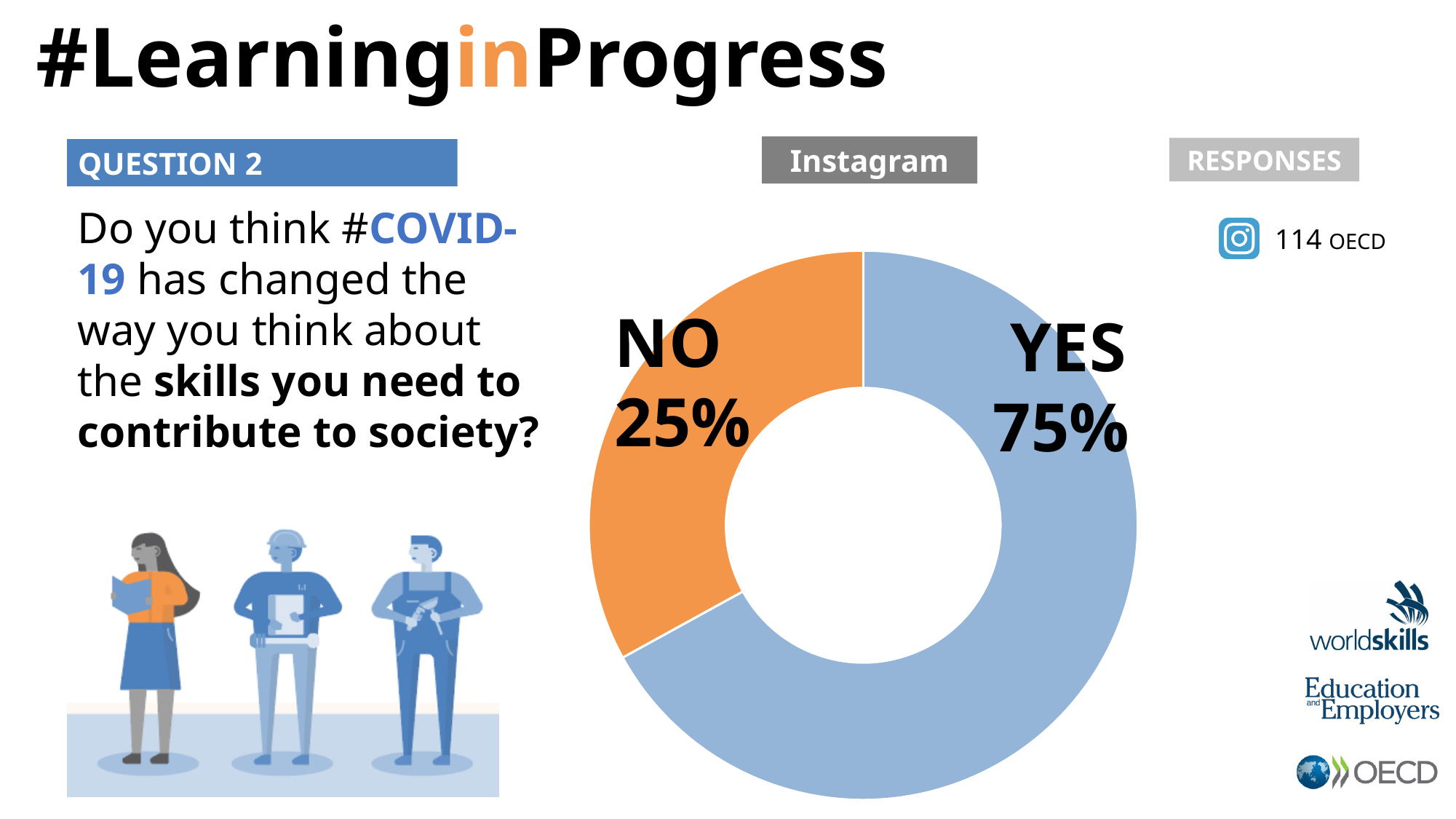
Which response has the smaller share of the chart? NO What colour is the NO segment of the chart? orange What colour is the YES segment of the chart? blue What percentage of respondents answered NO? 25% How many categories are shown in the chart? 2 What percentage of respondents answered YES? 75% What kind of chart is shown on the slide? pie chart (doughnut) Is the share for NO greater or less than 50%? less Which response has the larger share of the chart? YES What is the difference in percentage points between the YES and NO shares? 50 What is the total of the YES and NO shares? 100% Is the share for YES larger or smaller than the share for NO? larger